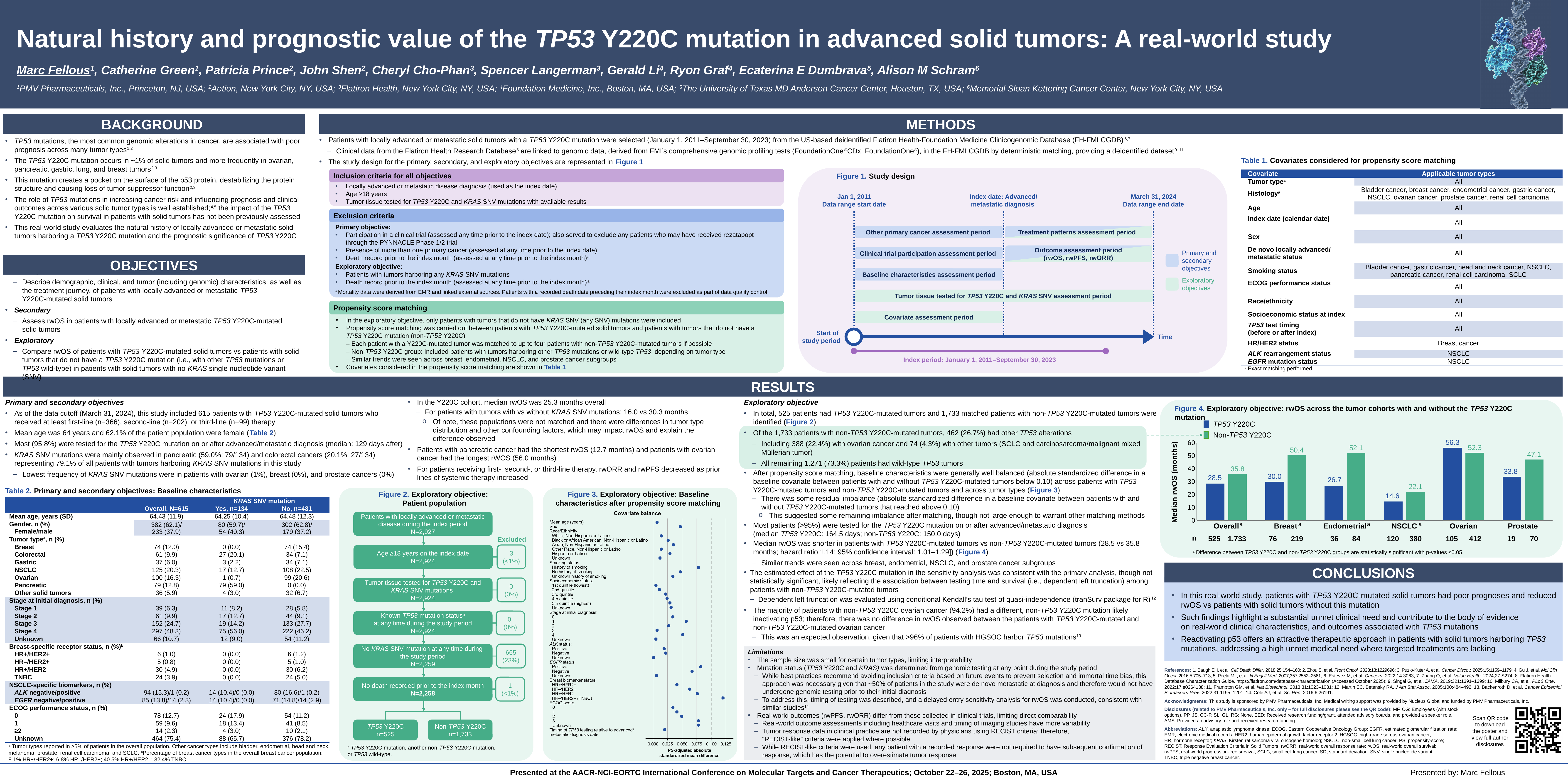
How many series does the legend of Figure 4 list? 2 In Figure 4, is the median rwOS for the Non-TP53 Y220C group in the Prostate cohort greater or less than 40? greater In Figure 4, which group has the larger median rwOS in the Ovarian cohort, TP53 Y220C or Non-TP53 Y220C? TP53 Y220C In Figure 4, which tumor cohort has the lowest median rwOS for the Non-TP53 Y220C group? NSCLC What kind of chart is Figure 4? Bar chart How many tumor cohorts are shown on the x axis of Figure 4? 6 In Figure 4, what is the median rwOS (months) for the TP53 Y220C group in the NSCLC cohort? 14.6 In Figure 4, what is the median rwOS (months) for the Non-TP53 Y220C group in the Endometrial cohort? 52.1 In Figure 4, what is the difference in median rwOS (months) between the Non-TP53 Y220C and TP53 Y220C groups in the Breast cohort? 20.4 In Figure 4, what is the median rwOS (months) for the TP53 Y220C group in the Overall cohort? 28.5 In Figure 4, which tumor cohort has the highest median rwOS for the TP53 Y220C group? Ovarian In Figure 4, what is the label of the y axis? Median rwOS (months)